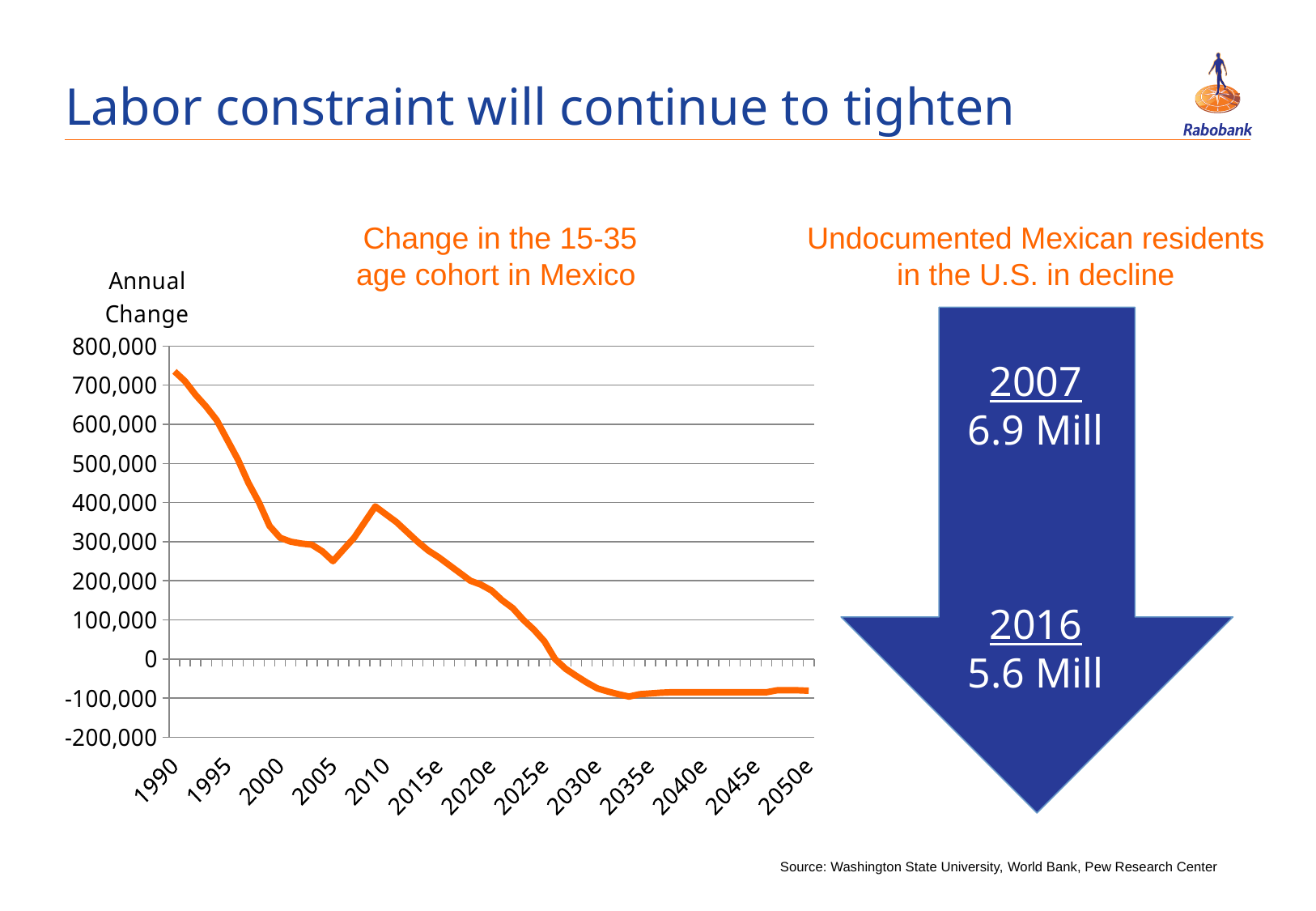
In the 'Change in the 15-35 age cohort in Mexico' chart, is the value for 1990 greater or less than 600,000? greater In the 'Change in the 15-35 age cohort in Mexico' chart, do the values generally rise or fall from 1990 to 2050e? fall In the 'Change in the 15-35 age cohort in Mexico' chart, is the value for 2020e greater or less than 300,000? less What is the label on the vertical axis of the 'Change in the 15-35 age cohort in Mexico' chart? Annual Change How many year labels are shown on the x axis of the 'Change in the 15-35 age cohort in Mexico' chart? 13 In the 'Change in the 15-35 age cohort in Mexico' chart, is the value for 2005 greater or less than 300,000? less What kind of chart is shown under the title 'Change in the 15-35 age cohort in Mexico'? line chart In the 'Change in the 15-35 age cohort in Mexico' chart, which is larger, the value for 1990 or the value for 2000? 1990 In the 'Change in the 15-35 age cohort in Mexico' chart, which is larger, the value for 2005 or the value for 2010? 2010 In the 'Change in the 15-35 age cohort in Mexico' chart, which year label has the highest value? 1990